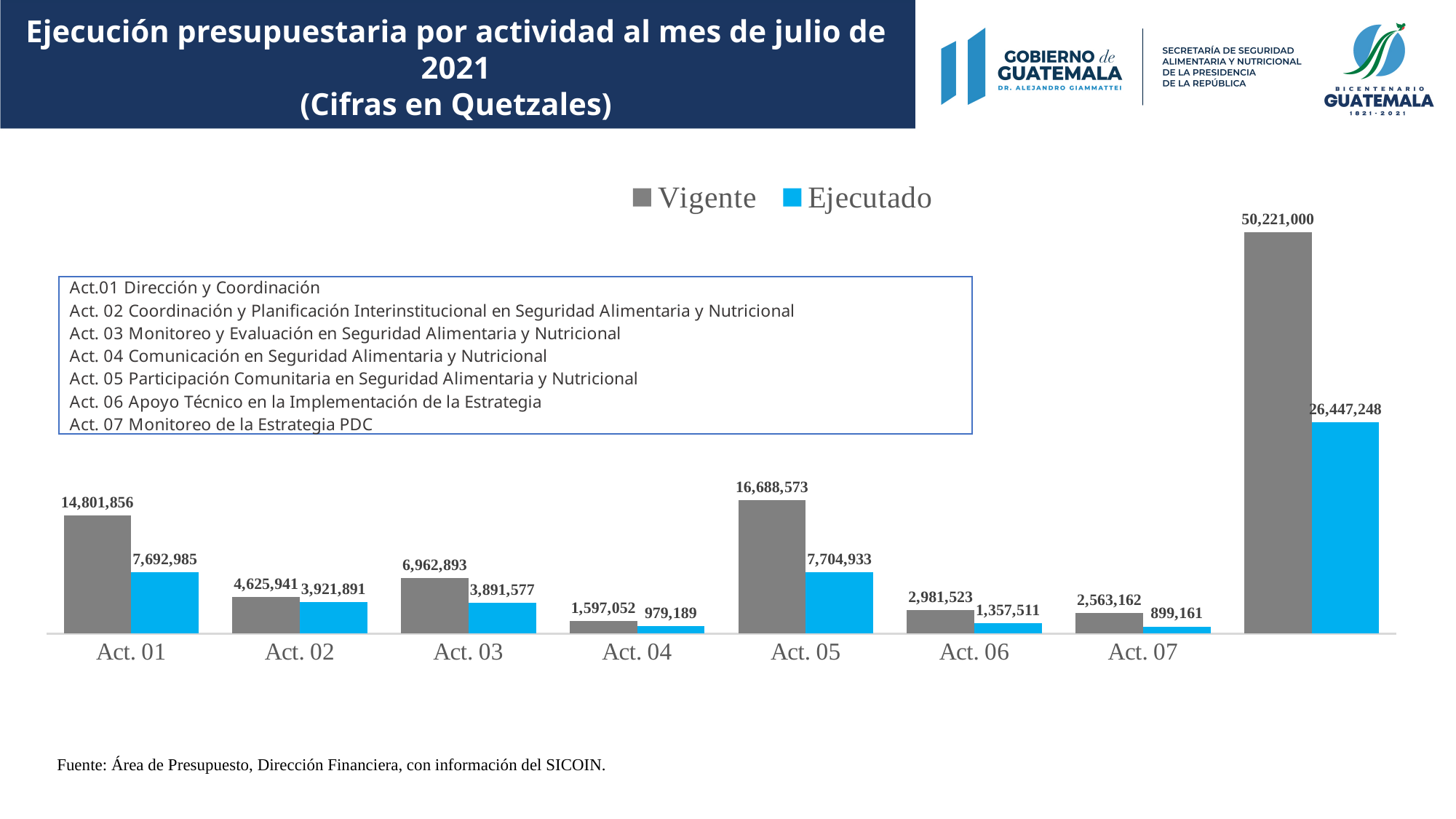
What is the difference between the Vigente and Ejecutado values for Act. 01? 7,108,871 Which is larger, the Ejecutado value for Act. 02 or the Ejecutado value for Act. 03? Act. 02 What is the Vigente value for Act. 03? 6,962,893 What kind of chart is shown on the slide? Bar chart What is the Vigente value for Act. 01? 14,801,856 How many activities (Act. 01 to Act. 07) are labeled on the x axis? 7 Which colour represents the Ejecutado series in the chart? Blue What is the Ejecutado value for Act. 07? 899,161 Among Act. 01 to Act. 07, which activity has the lowest Ejecutado value? Act. 07 How many series does the legend list? 2 What is the Ejecutado value for Act. 05? 7,704,933 Among Act. 01 to Act. 07, which activity has the highest Vigente value? Act. 05